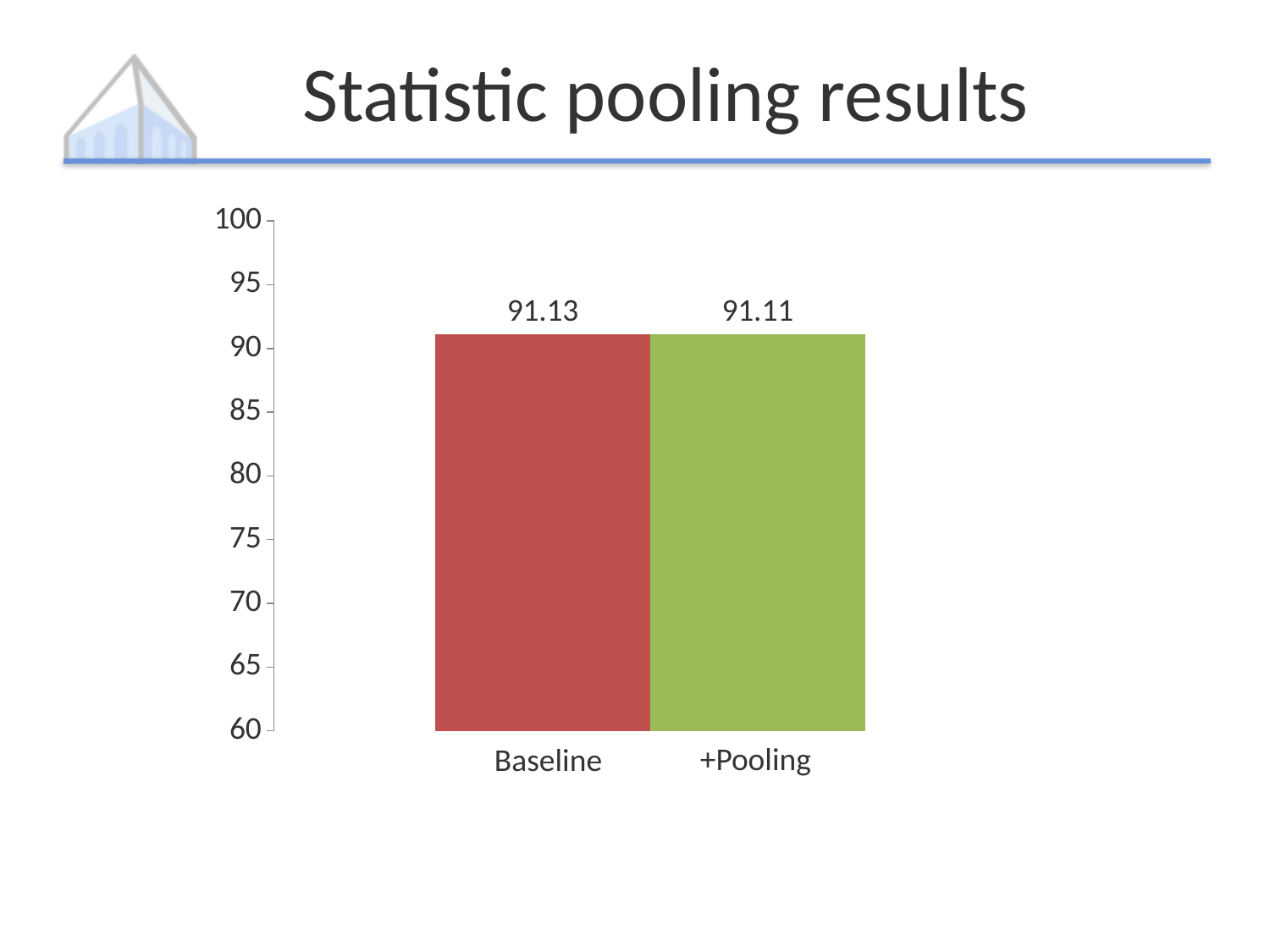
How many bars are shown in the chart? 2 Is the value for +Pooling greater or less than 95? less What kind of chart is shown on the slide? bar chart What colour is the Baseline bar? red What is the difference between the Baseline value and the +Pooling value? 0.02 What is the title of the slide containing the chart? Statistic pooling results Which category has the higher value, Baseline or +Pooling? Baseline Is the value for Baseline greater or less than 90? greater What is the value for Baseline? 91.13 What is the lowest value shown on the vertical axis? 60 Do the values rise or fall from Baseline to +Pooling? fall What is the value for +Pooling? 91.11